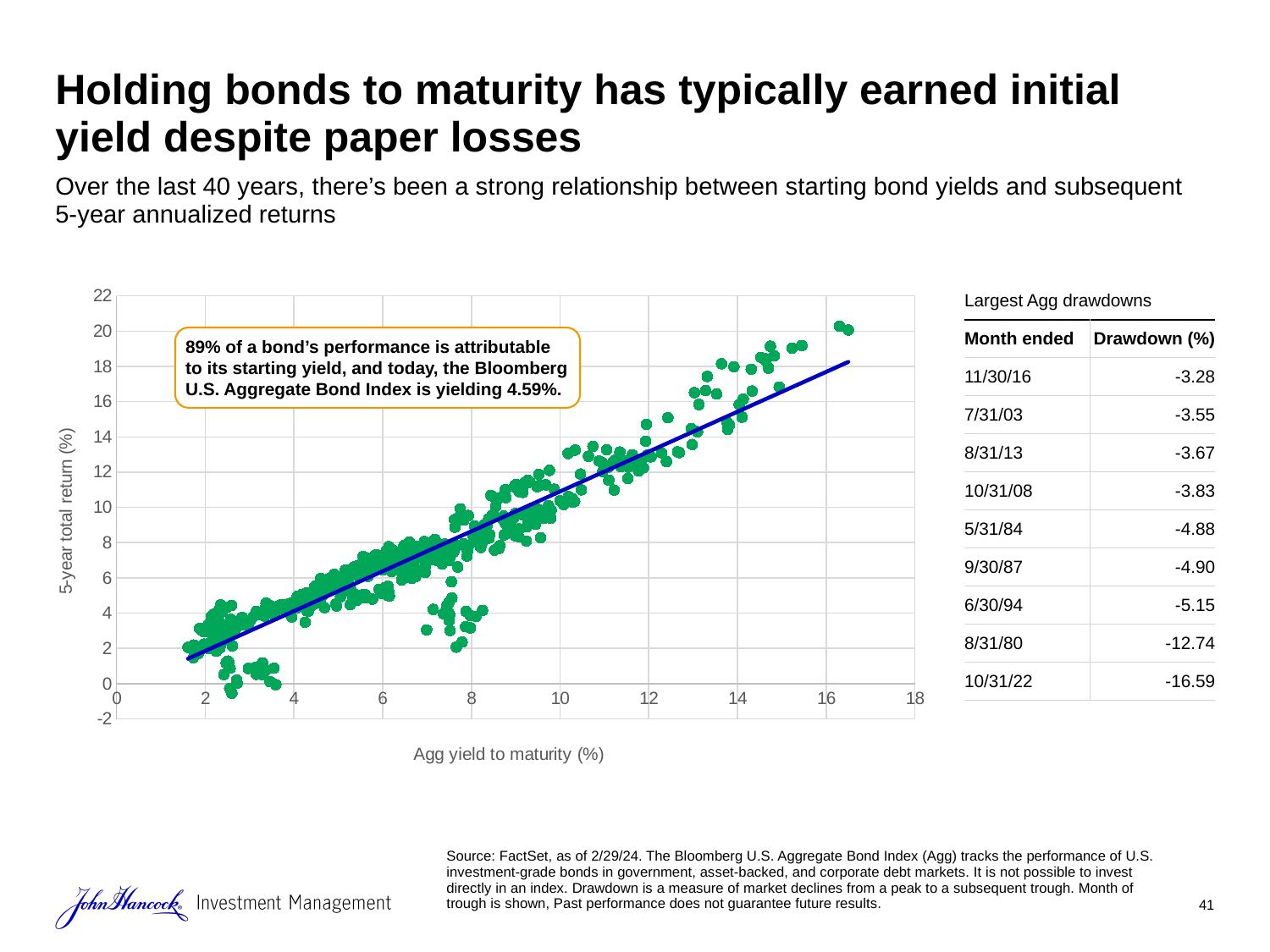
Is the lowest 5-year total return plotted on the chart greater or less than 2? less According to the annotation on the chart, what percentage of a bond's performance is attributable to its starting yield? 89% What is the maximum value shown on the y axis of the scatter chart? 22 What is the label of the x axis of the scatter chart? Agg yield to maturity (%) According to the annotation on the chart, what is the Bloomberg U.S. Aggregate Bond Index yielding today? 4.59% What kind of chart is shown on the slide? Scatter chart What is the maximum value shown on the x axis of the scatter chart? 18 What is the label of the y axis of the scatter chart? 5-year total return (%) As Agg yield to maturity increases along the x axis, do the 5-year total return values generally rise or fall? Rise Is the highest 5-year total return plotted on the chart greater or less than 18? greater Is the highest Agg yield to maturity plotted on the chart greater or less than 14? greater